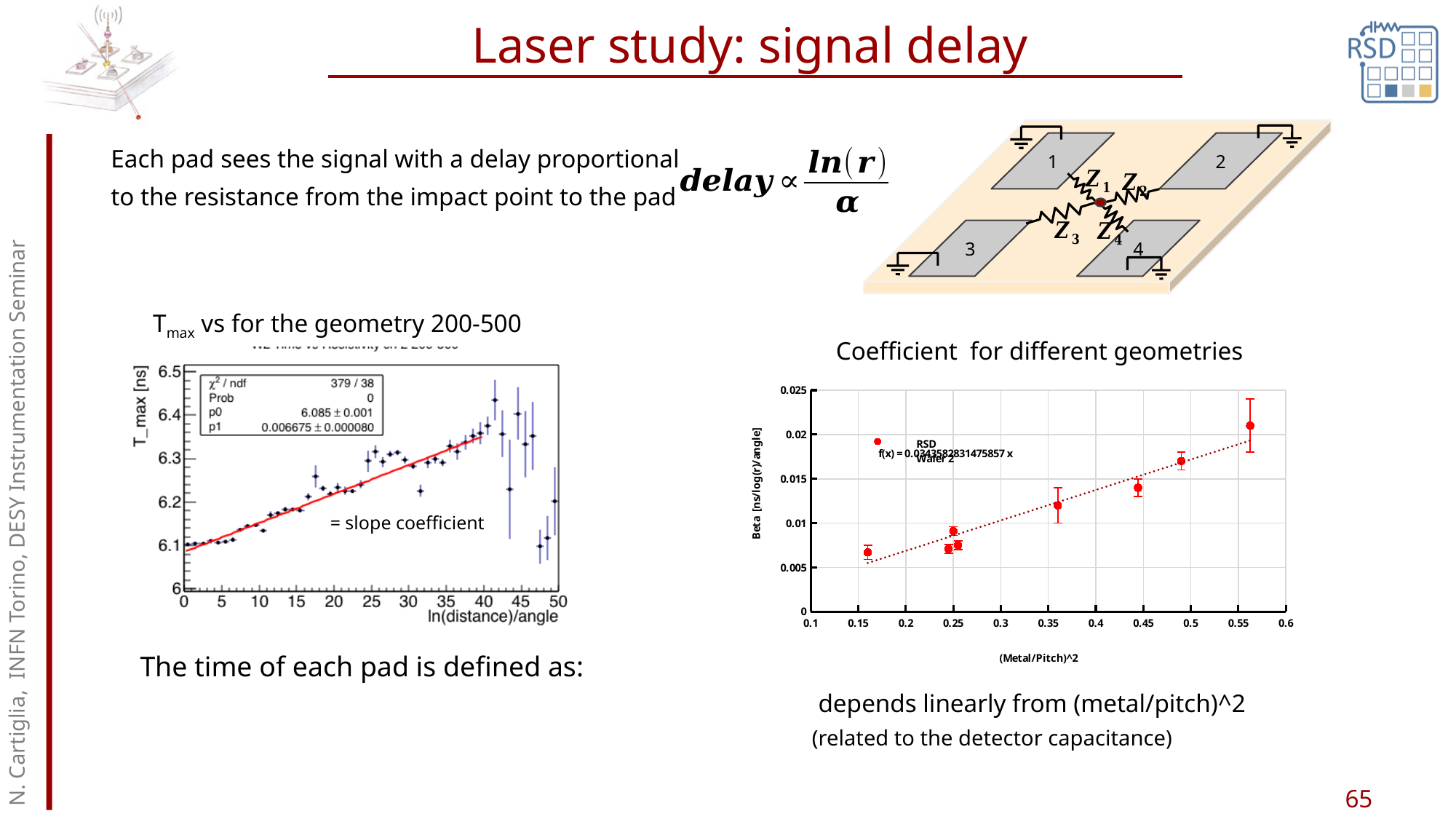
In the left chart of T_max vs ln(distance)/angle, what is the fitted value of p1? 0.006675 ± 0.000080 In the 'Coefficient for different geometries' chart, what is the label of the x axis? (Metal/Pitch)^2 In the 'Coefficient for different geometries' chart, is the Beta value for the point near (Metal/Pitch)^2 = 0.36 greater or less than 0.01? greater In the 'Coefficient for different geometries' chart, which point has the highest Beta value: the one near (Metal/Pitch)^2 = 0.56 or the one near 0.49? the one near 0.56 In the 'Coefficient for different geometries' chart, do the Beta values rise or fall as (Metal/Pitch)^2 increases? rise In the 'Coefficient for different geometries' chart, is the Beta value for the point near (Metal/Pitch)^2 = 0.16 greater or less than 0.01? less In the left chart of T_max vs ln(distance)/angle, what is the fitted value of p0? 6.085 ± 0.001 In the 'Coefficient for different geometries' chart, what is the fitted trendline equation shown? f(x) = 0.0343582831475857 x In the left chart of T_max vs ln(distance)/angle, what is the chi-squared / ndf of the fit? 379 / 38 What kind of chart is the 'Coefficient for different geometries' chart on the right? scatter chart In the 'Coefficient for different geometries' chart, how many data points are plotted? 8 In the 'Coefficient for different geometries' chart, what is the label of the y axis? Beta [ns/log(r)/angle]